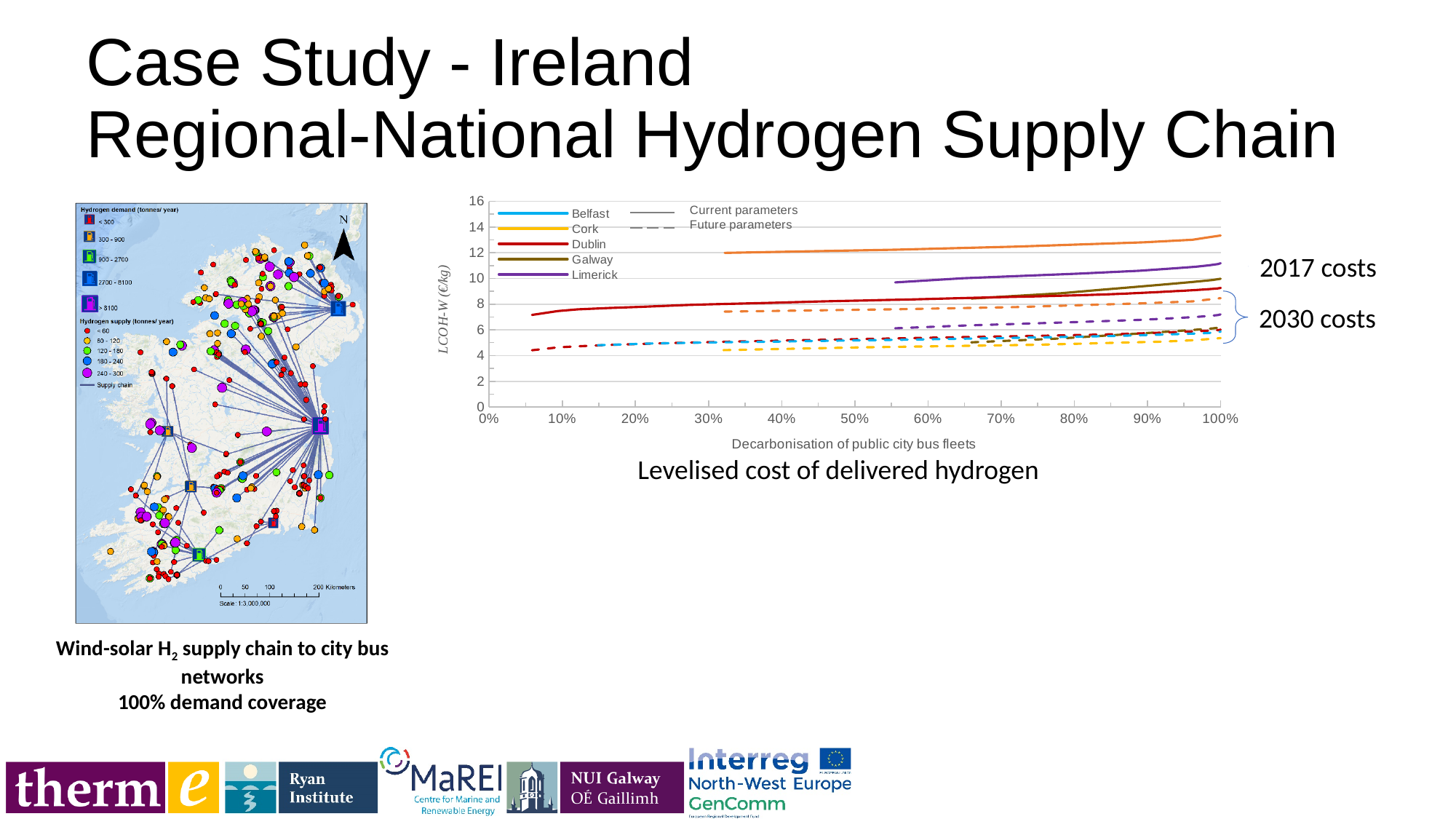
In the 'Levelised cost of delivered hydrogen' chart, what does a dashed line represent according to the legend? Future parameters In the 'Levelised cost of delivered hydrogen' chart, is the Dublin current-parameters value at 100% greater or less than 8? greater In the 'Levelised cost of delivered hydrogen' chart, is the Dublin current-parameters value at 10% greater or less than 8? less In the 'Levelised cost of delivered hydrogen' chart, which is higher at 100%: the Limerick current-parameters line or the Dublin current-parameters line? Limerick What is the x-axis title of the 'Levelised cost of delivered hydrogen' chart? Decarbonisation of public city bus fleets What kind of chart is 'Levelised cost of delivered hydrogen'? line chart In the 'Levelised cost of delivered hydrogen' chart, does the Dublin current-parameters line rise or fall as decarbonisation increases? rise In the 'Levelised cost of delivered hydrogen' chart, is the Limerick current-parameters value at 100% greater or less than 10? greater How many cities does the legend of the 'Levelised cost of delivered hydrogen' chart list? 5